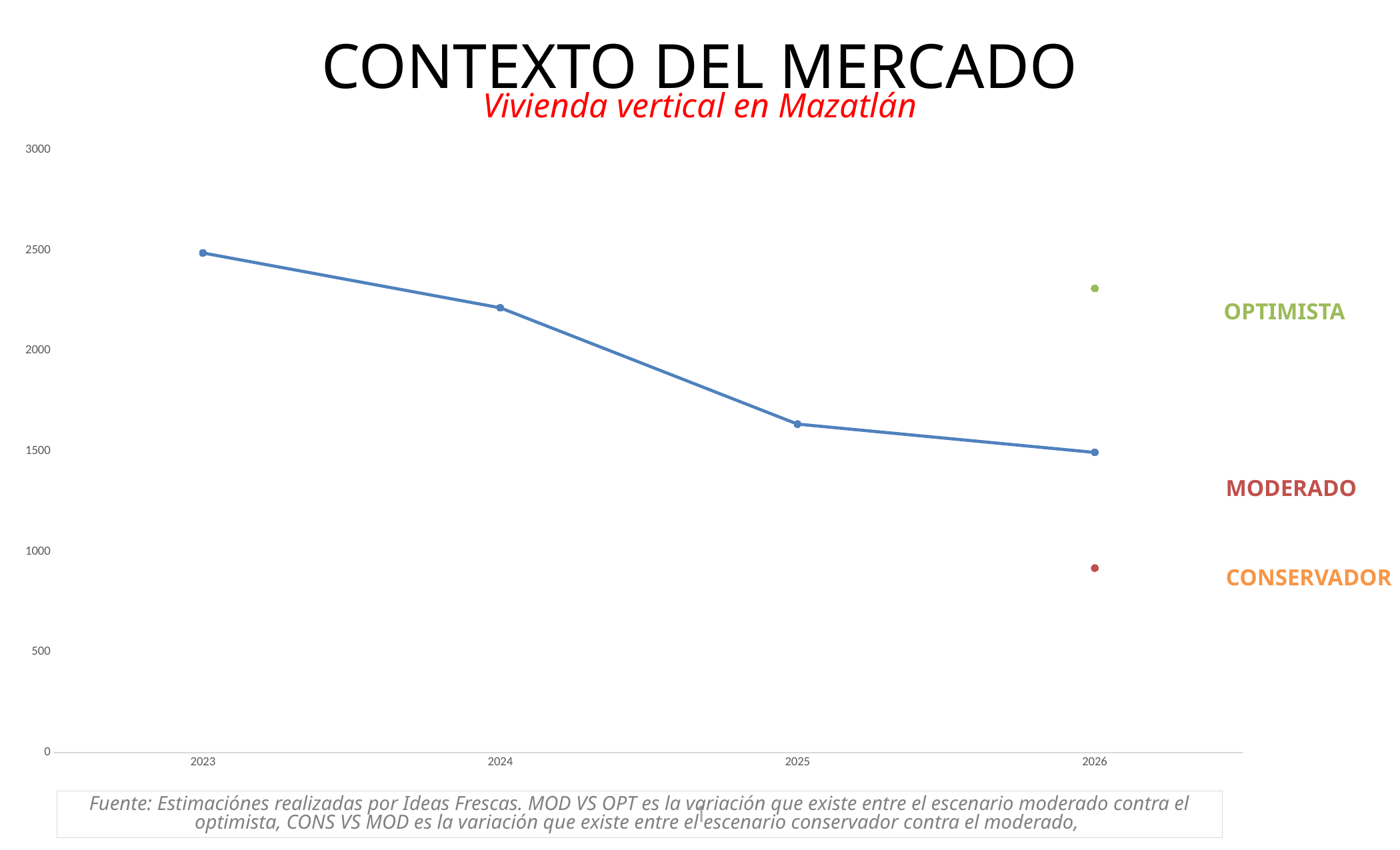
Does the blue line rise or fall from 2023 to 2026? fall What is the red subtitle shown under the slide title? Vivienda vertical en Mazatlán Is the value of the blue line for 2026 greater or less than 1000? greater In which year does the blue line reach its lowest value? 2026 Is the value of the blue line for 2025 greater or less than 2000? less Is the OPTIMISTA point for 2026 greater or less than 2000? greater What kind of chart is shown on the slide? line chart In which year does the blue line reach its highest value? 2023 How many years are shown on the x axis of the chart? 4 Which is larger in 2026, the OPTIMISTA point or the CONSERVADOR point? OPTIMISTA